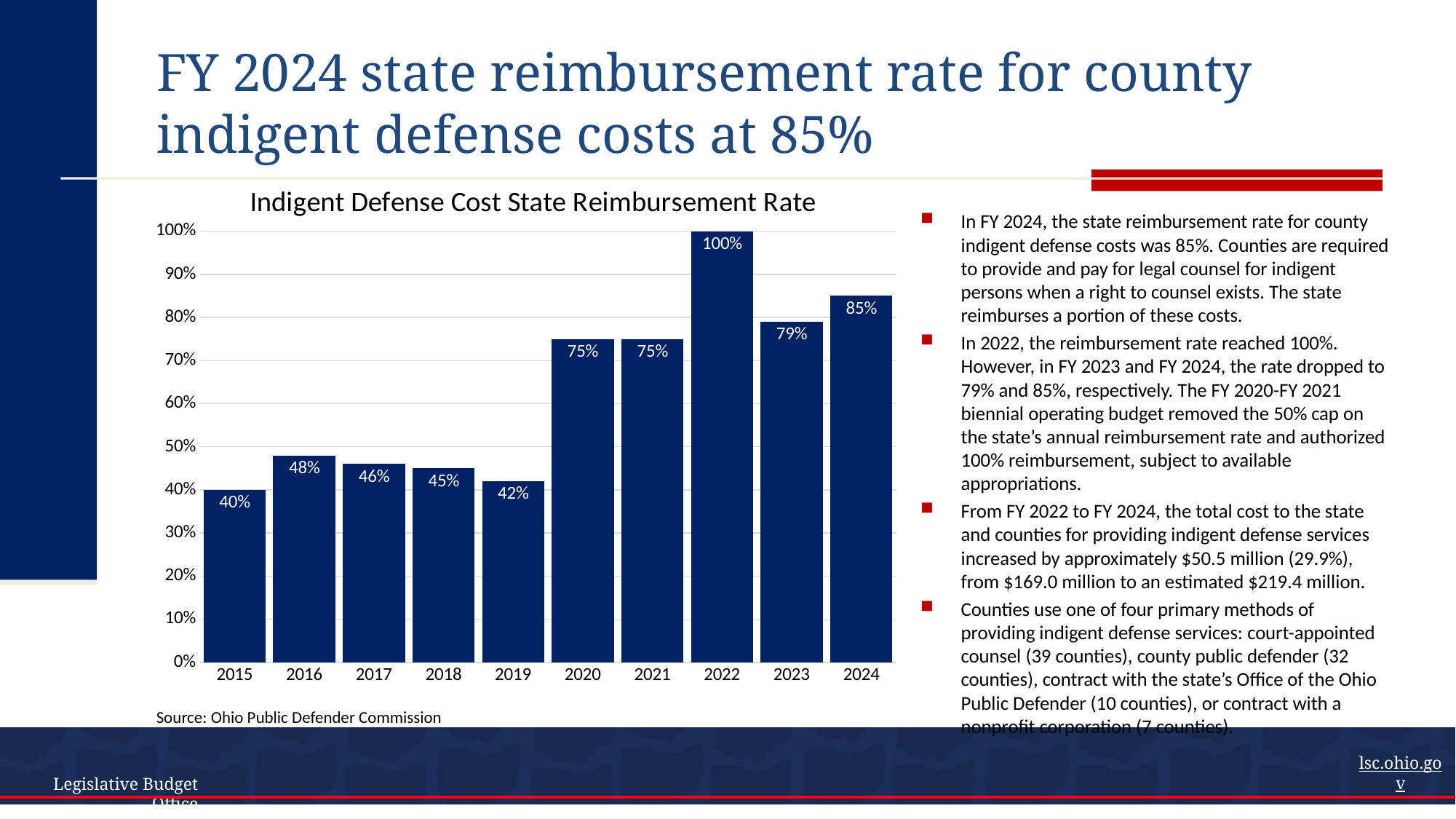
What is the difference in percentage points between the 2022 rate and the 2023 rate? 21 percentage points What source is cited below the chart? Ohio Public Defender Commission Which year has the highest reimbursement rate in the chart? 2022 Is the value for 2020 greater or less than 70%? greater What is the title of the chart? Indigent Defense Cost State Reimbursement Rate Which year has a higher reimbursement rate, 2016 or 2018? 2016 Do the reimbursement rates rise or fall from 2016 to 2019? Fall Which year has the lowest reimbursement rate in the chart? 2015 What is the state reimbursement rate shown for 2019? 42% How many years are shown on the x axis of the chart? 10 What is the state reimbursement rate shown for 2023? 79% What kind of chart is used to show the reimbursement rate? Bar chart